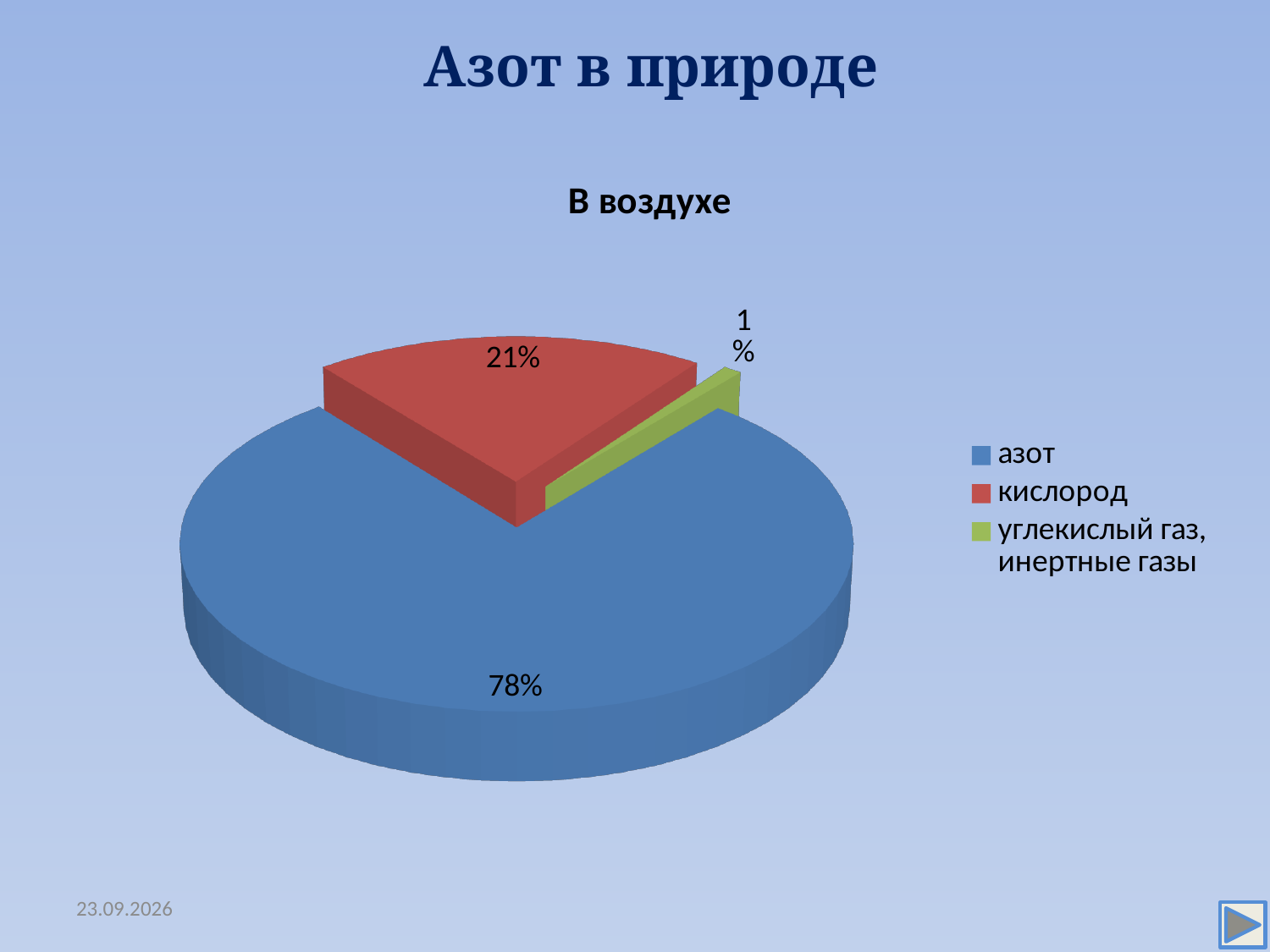
What is the chart's title? В воздухе What colour is the slice for кислород? red What kind of chart is shown on the slide? pie chart Which category has the smallest slice of the pie? углекислый газ, инертные газы What share of the pie does углекислый газ, инертные газы have? 1% What is the difference between the shares of азот and кислород? 57% What share of the pie does кислород have? 21% What share of the pie does азот have? 78% What is the difference between the shares of кислород and углекислый газ, инертные газы? 20% How many categories does the legend list? 3 Which category has the largest slice of the pie? азот Which is larger, the share of кислород or the share of углекислый газ, инертные газы? кислород